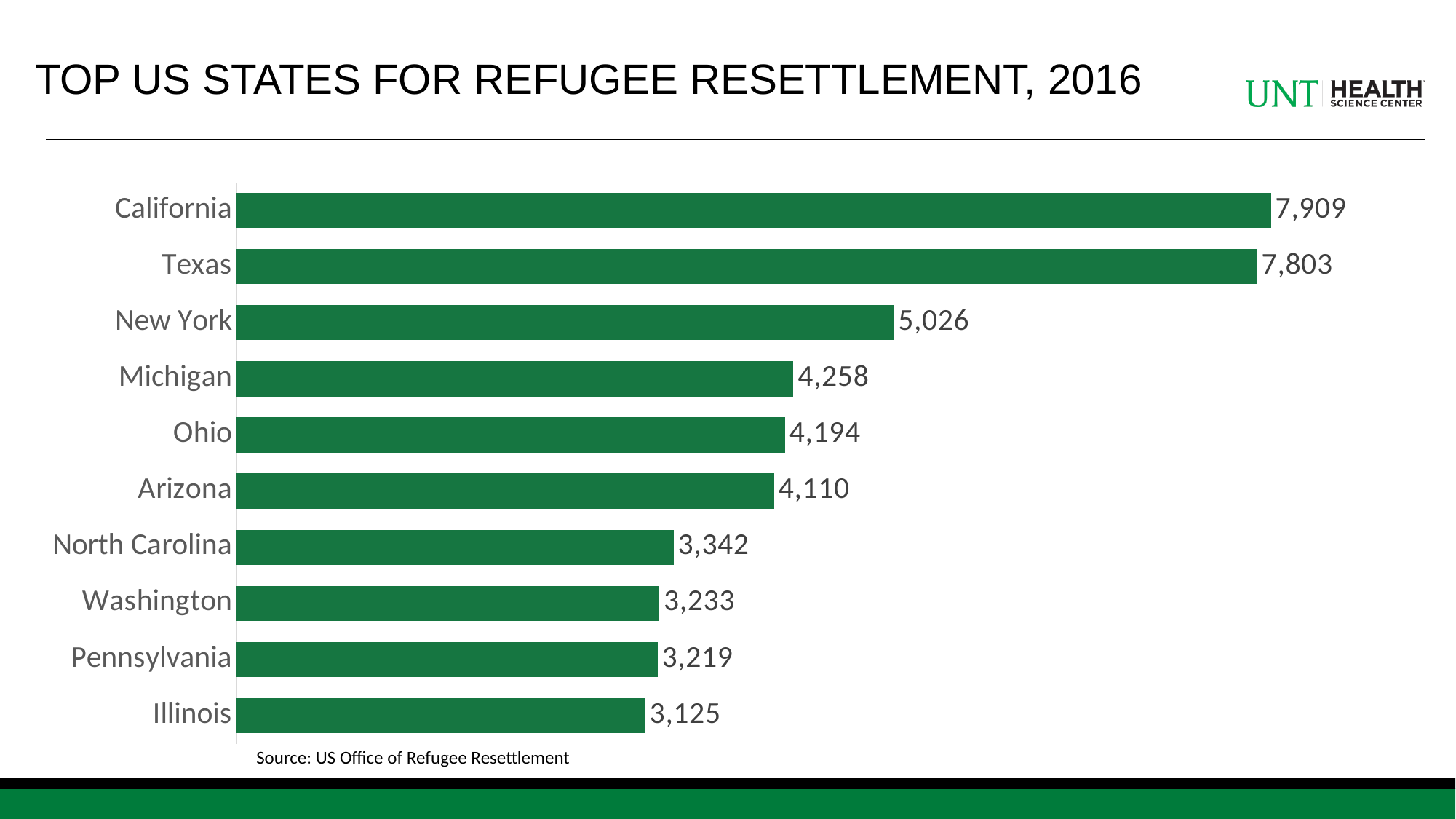
What is the difference between the values for New York and Michigan? 768 How many states are shown in the chart? 10 Which state has the lowest value? Illinois Which is larger, the value for Arizona or the value for North Carolina? Arizona What is the source cited below the chart? US Office of Refugee Resettlement What is the value for Illinois? 3,125 What is the difference between the values for California and Texas? 106 What is the value for California? 7,909 Which state has the highest value? California What kind of chart is shown on the slide? Bar chart What is the value for Michigan? 4,258 Which is larger, the value for New York or the value for Ohio? New York